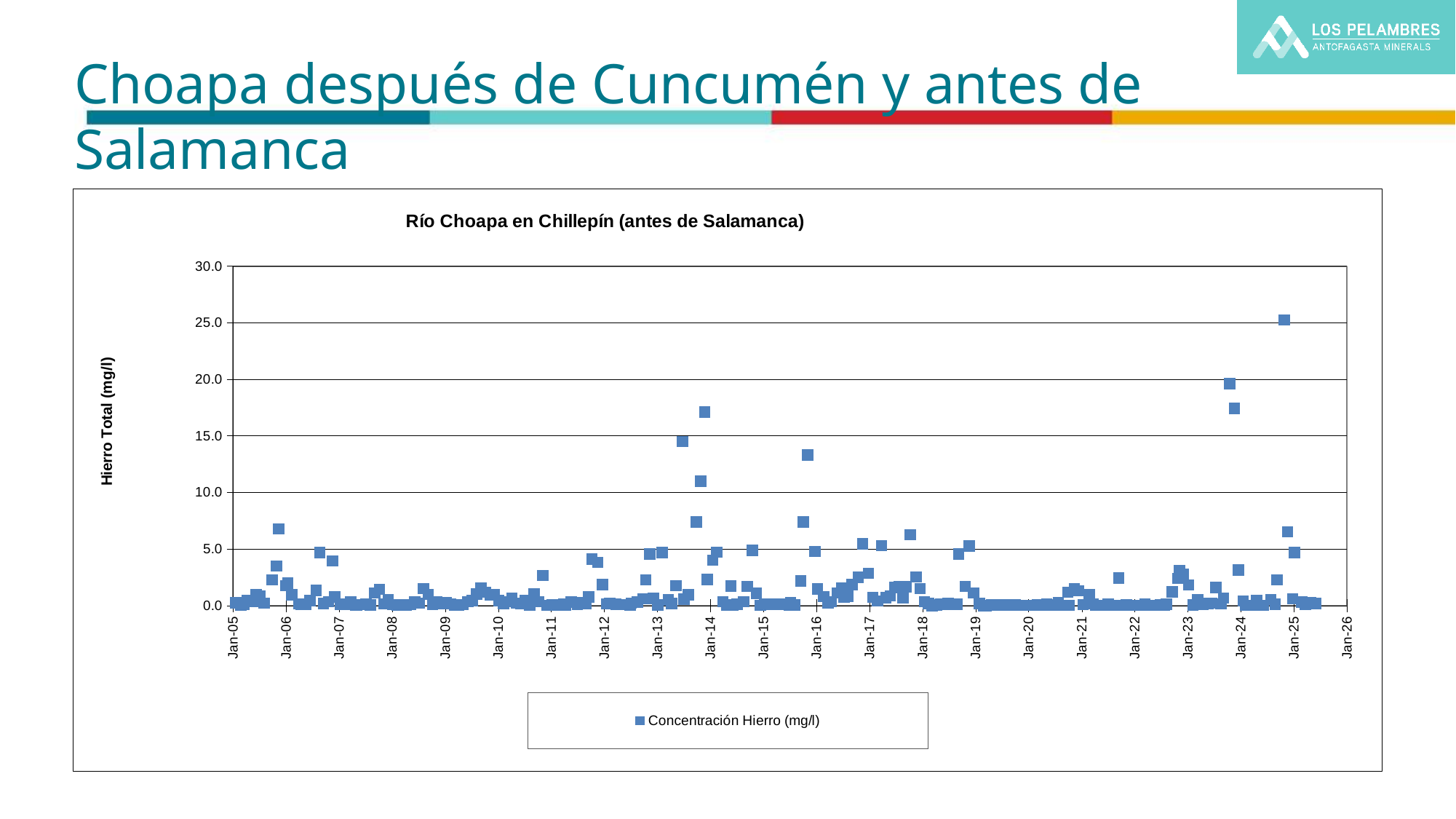
What is the label of the series in the legend? Concentración Hierro (mg/l) Is the highest plotted value near Jan-14 greater or less than 20.0? less Which is larger: the highest value near Jan-25 or the highest value near Jan-14? the highest value near Jan-25 Is the highest plotted value on the chart greater or less than 20.0? greater What is the title of the chart? Río Choapa en Chillepín (antes de Salamanca) How many series does the legend list? 1 What kind of chart is shown on the slide? scatter chart Is the highest plotted value between Jan-23 and Jan-24 greater or less than 15.0? greater Around which year does the highest plotted value occur? Jan-25